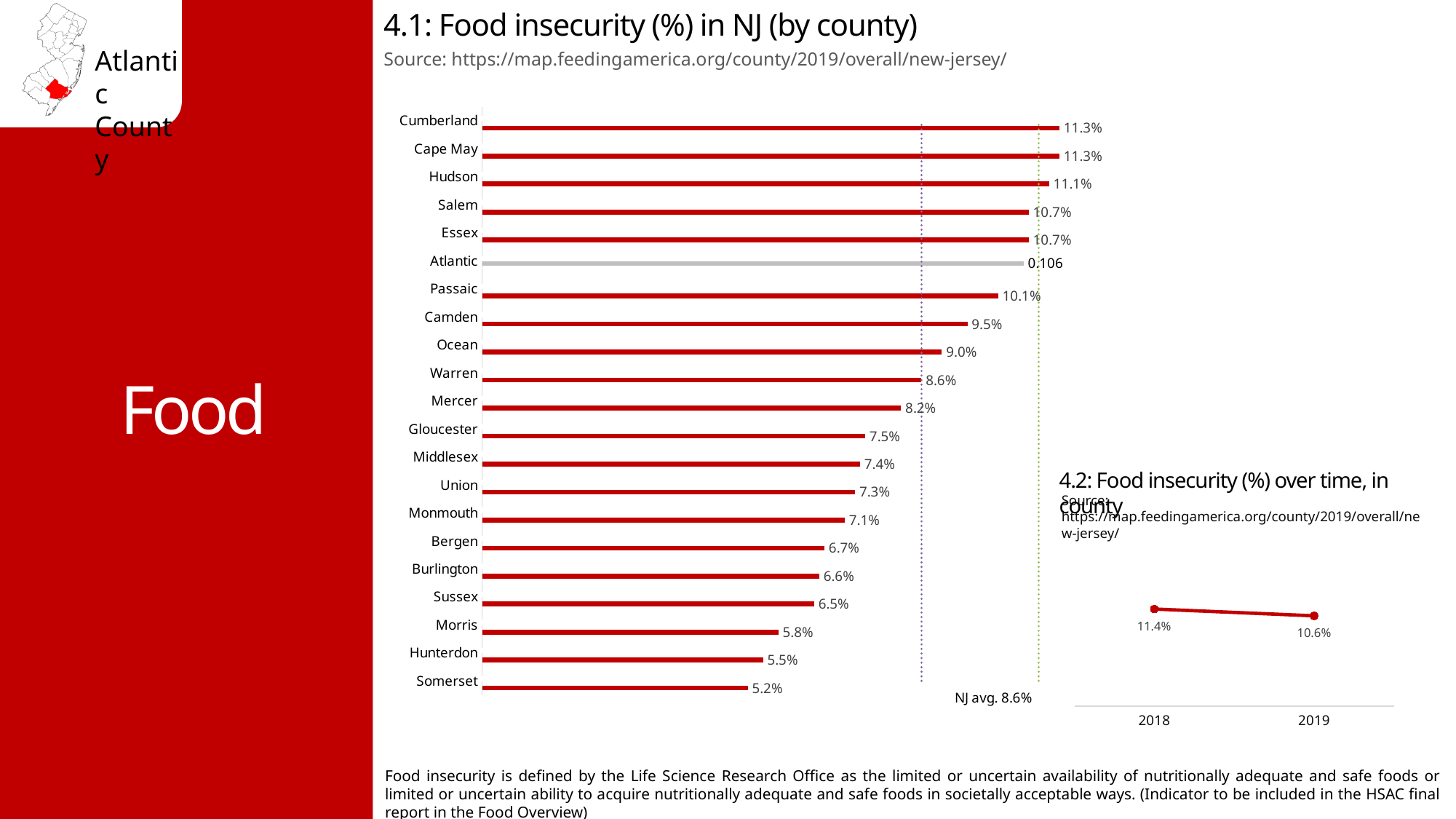
In the chart '4.1: Food insecurity (%) in NJ (by county)', how many counties are plotted? 21 In the chart '4.2: Food insecurity (%) over time, in county', what is the difference between the 2018 and 2019 values? 0.8% In the chart '4.2: Food insecurity (%) over time, in county', do values rise or fall from 2018 to 2019? Fall In the chart '4.1: Food insecurity (%) in NJ (by county)', which is larger, Camden or Ocean? Camden What kind of chart is '4.1: Food insecurity (%) in NJ (by county)'? Bar chart In the chart '4.1: Food insecurity (%) in NJ (by county)', which county has the lowest value? Somerset In the chart '4.1: Food insecurity (%) in NJ (by county)', what is the value for Hudson? 11.1% In the chart '4.1: Food insecurity (%) in NJ (by county)', what is the difference between Hudson and Somerset? 5.9% In the chart '4.2: Food insecurity (%) over time, in county', what is the value for 2018? 11.4% In the chart '4.1: Food insecurity (%) in NJ (by county)', what value is labelled for Atlantic? 0.106 In the chart '4.1: Food insecurity (%) in NJ (by county)', what is the value for Warren? 8.6% In the chart '4.2: Food insecurity (%) over time, in county', what is the value for 2019? 10.6%